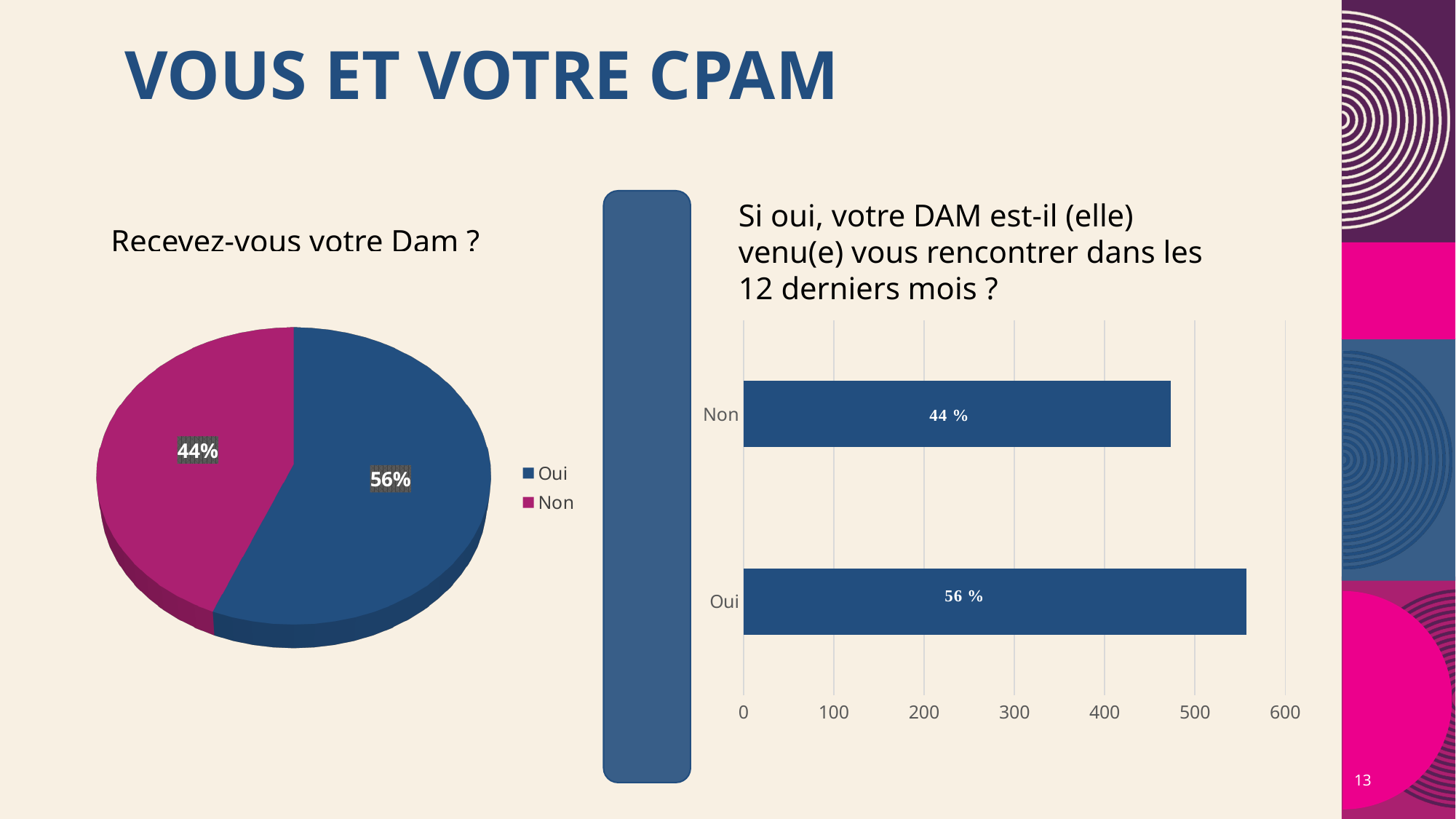
What kind of chart is the left chart titled 'Recevez-vous votre Dam ?'? Pie chart In the pie chart 'Recevez-vous votre Dam ?', which slice is the largest? Oui What kind of chart is the right chart titled 'Si oui, votre DAM est-il (elle) venu(e) vous rencontrer dans les 12 derniers mois ?'? Bar chart In the pie chart 'Recevez-vous votre Dam ?', what percentage is shown for Non? 44% In the bar chart 'Si oui, votre DAM est-il (elle) venu(e) vous rencontrer dans les 12 derniers mois ?', what label is printed on the Oui bar? 56 % In the pie chart 'Recevez-vous votre Dam ?', what is the difference in percentage points between Oui and Non? 12 percentage points In the bar chart 'Si oui, votre DAM est-il (elle) venu(e) vous rencontrer dans les 12 derniers mois ?', how many categories are shown? 2 In the bar chart 'Si oui, votre DAM est-il (elle) venu(e) vous rencontrer dans les 12 derniers mois ?', is the bar for Non greater or less than 400 on the axis? greater In the bar chart 'Si oui, votre DAM est-il (elle) venu(e) vous rencontrer dans les 12 derniers mois ?', which category has the longer bar? Oui In the bar chart 'Si oui, votre DAM est-il (elle) venu(e) vous rencontrer dans les 12 derniers mois ?', what label is printed on the Non bar? 44 % In the pie chart 'Recevez-vous votre Dam ?', what percentage is shown for Oui? 56% How many entries does the legend of the pie chart 'Recevez-vous votre Dam ?' list? 2